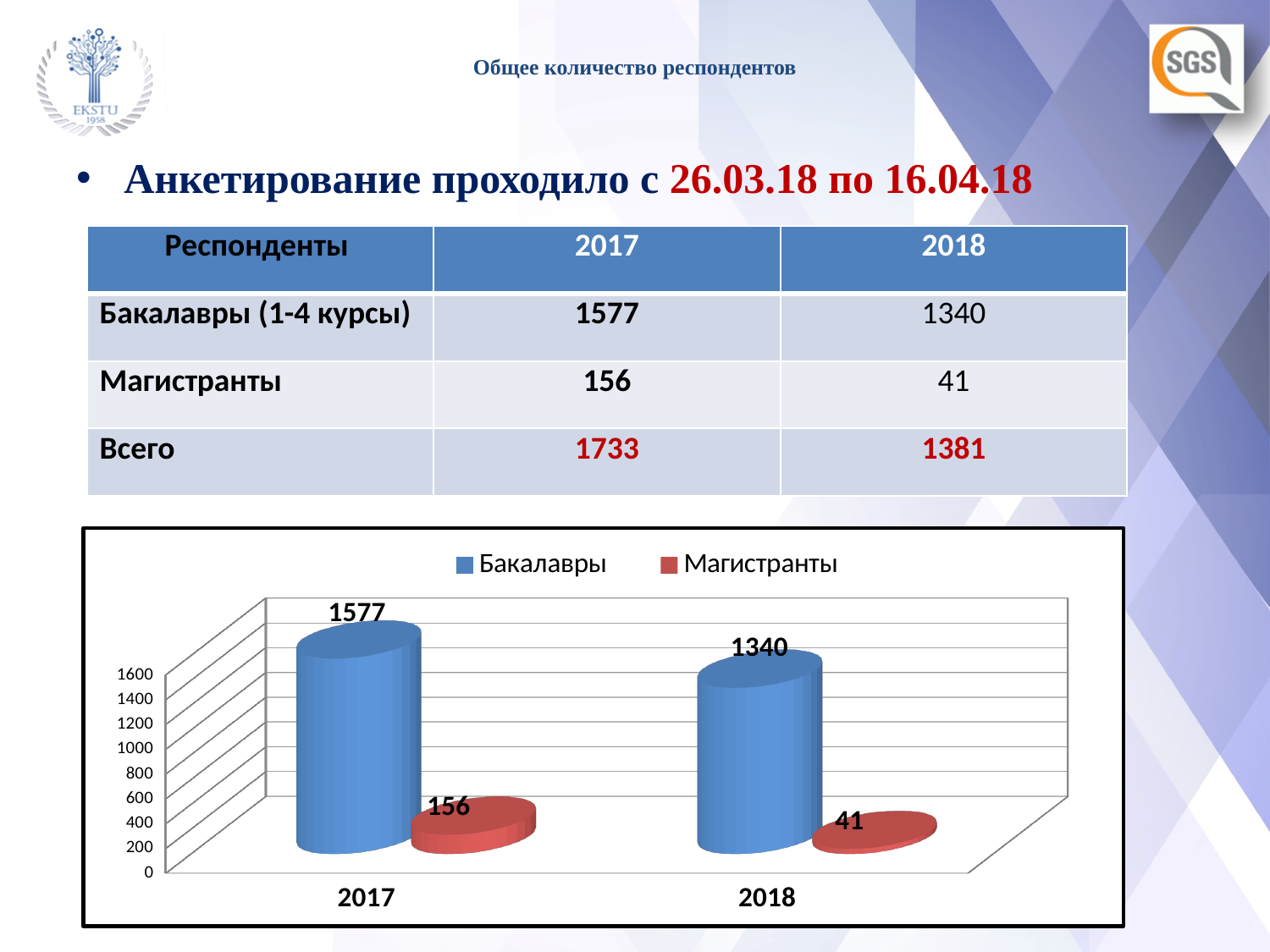
Do the Магистранты values rise or fall from 2017 to 2018? fall What is the value for Бакалавры in 2017? 1577 Which colour represents Магистранты in the chart? red How many series does the legend list? 2 Which year has the higher value for Бакалавры? 2017 What is the value for Магистранты in 2017? 156 How many categories are shown on the x axis? 2 What is the difference between the Бакалавры values for 2017 and 2018? 237 What is the value for Бакалавры in 2018? 1340 What is the difference between the Магистранты values for 2017 and 2018? 115 What kind of chart is shown on the slide? bar chart What is the value for Магистранты in 2018? 41